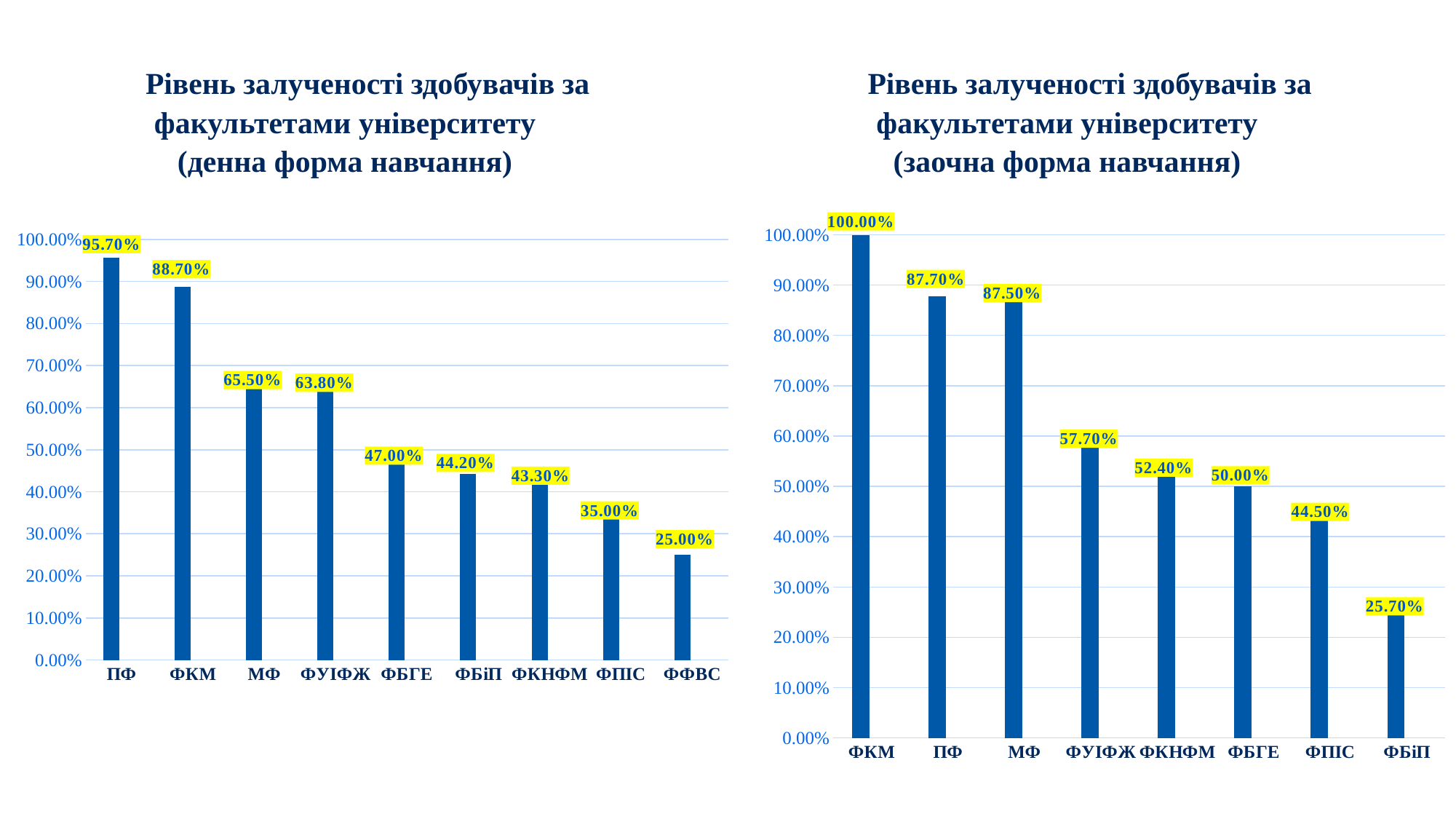
In the left chart (денна форма навчання), do the values rise or fall from left to right along the x axis? fall What type of chart is the right chart (заочна форма навчання)? bar chart In the left chart (денна форма навчання), what is the value for ФКМ? 88.70% In the left chart (денна форма навчання), which faculty has the highest value? ПФ In the right chart (заочна форма навчання), which faculty has the lowest value? ФБіП How many faculties are shown in the left chart (денна форма навчання)? 9 In the right chart (заочна форма навчання), what is the difference between the values for ФКМ and ФБіП? 74.30% In the left chart (денна форма навчання), what is the difference between the values for ПФ and ФФВС? 70.70% How many faculties are shown in the right chart (заочна форма навчання)? 8 In the left chart (денна форма навчання), which is larger: the value for МФ or the value for ФБГЕ? МФ In the right chart (заочна форма навчання), is the value for ФПІС greater or less than 50.00%? less In the right chart (заочна форма навчання), what is the value for ФУІФЖ? 57.70%